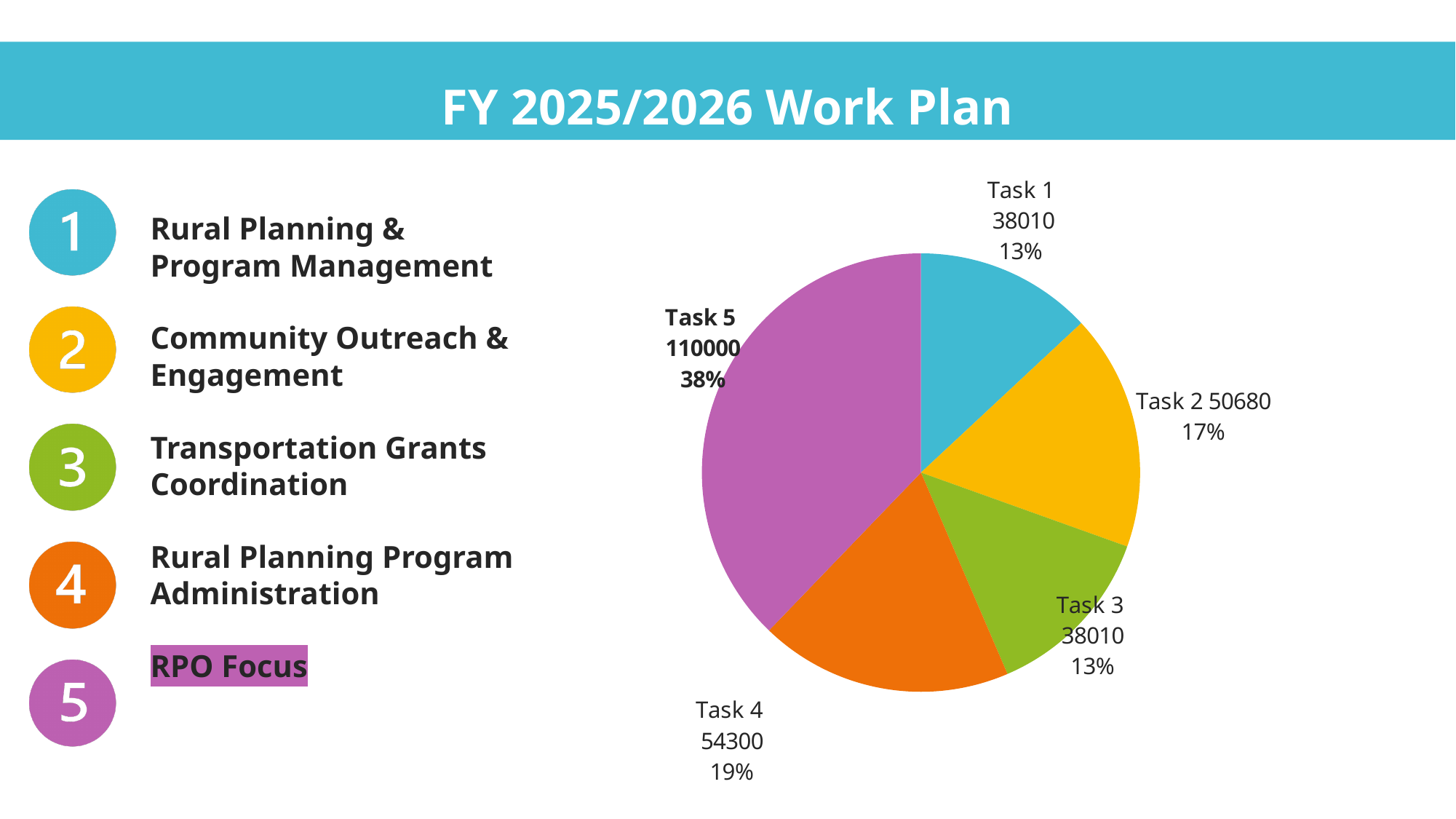
What is the difference between the values for Task 2 and Task 1? 12670 What percentage share does Task 4 have in the pie chart? 19% What is the difference between the values for Task 5 and Task 4? 55700 Which task has the largest slice in the pie chart? Task 5 What is the value for Task 5 in the pie chart? 110000 What is the value for Task 4 in the pie chart? 54300 What colour is the Task 5 slice in the pie chart? purple What is the value for Task 2 in the pie chart? 50680 Which is larger, the value for Task 4 or the value for Task 2? Task 4 How many slices does the pie chart have? 5 What kind of chart is shown on the slide? pie chart What percentage share does Task 5 have in the pie chart? 38%